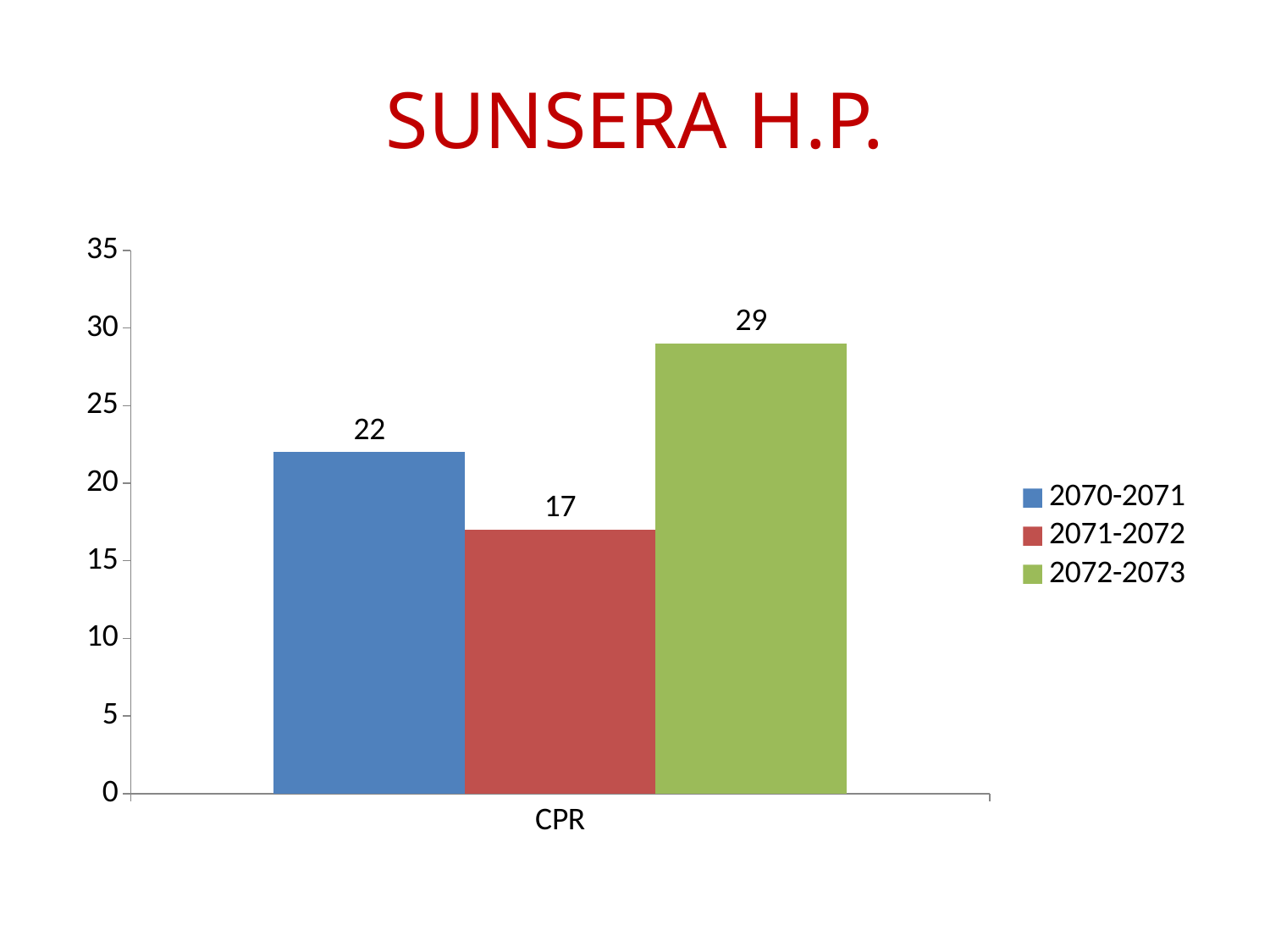
Is the CPR value for 2071-2072 greater or less than 20? less What is the title of the slide? SUNSERA H.P. What is the CPR value for 2070-2071? 22 How many series does the legend list? 3 Which is larger, the CPR value for 2070-2071 or for 2072-2073? 2072-2073 What is the difference between the CPR values for 2070-2071 and 2071-2072? 5 What kind of chart is shown on the slide? bar chart Which series has the lowest CPR value? 2071-2072 What is the CPR value for 2072-2073? 29 What is the CPR value for 2071-2072? 17 What is the difference between the CPR values for 2072-2073 and 2071-2072? 12 Which series has the highest CPR value? 2072-2073